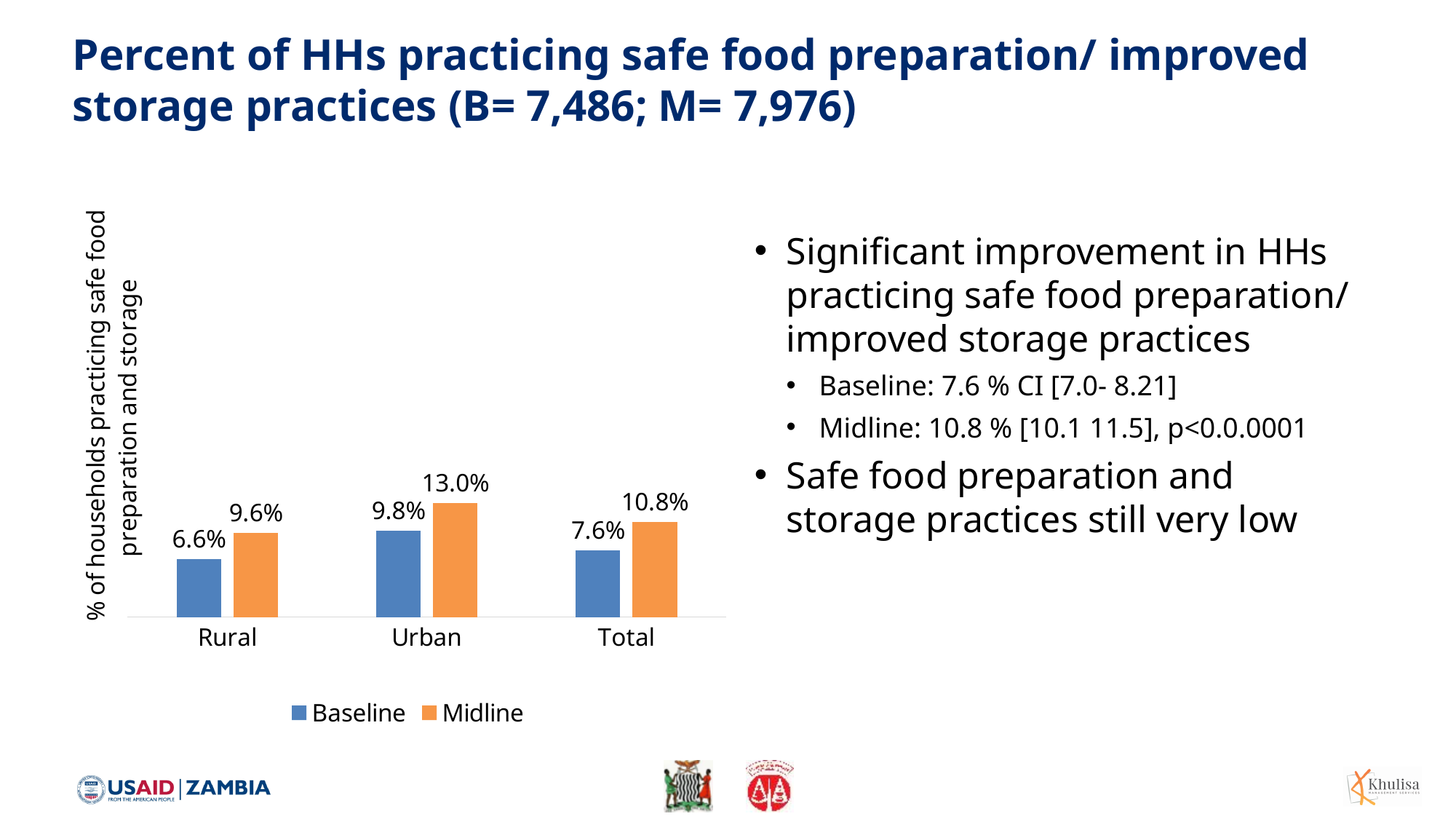
What is the Baseline value for Urban? 9.8% What is the Midline value for Urban? 13.0% How many series does the legend list? 2 Which is larger, the Midline value for Rural or the Baseline value for Urban? Baseline value for Urban Which category has the highest Midline value? Urban What is the difference between the Midline and Baseline values for Rural? 3.0% What is the Midline value for Total? 10.8% What is the Baseline value for Rural? 6.6% Which category has the lowest Baseline value? Rural What kind of chart is shown on the slide? Bar chart How many categories are shown on the x axis? 3 What is the difference between the Midline and Baseline values for Urban? 3.2%